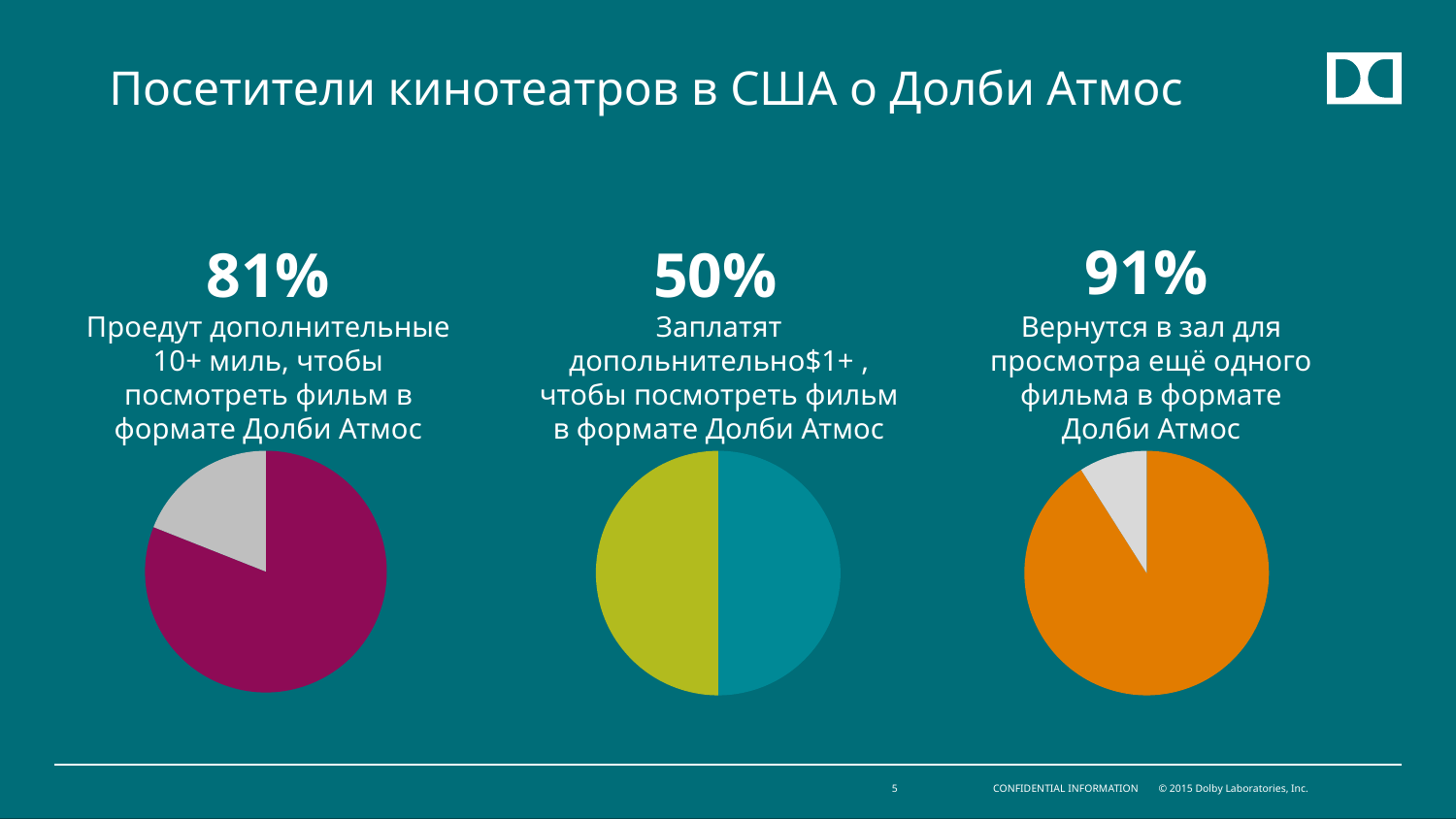
What percentage of US moviegoers would pay an extra $1+ to see a film in Dolby Atmos (middle chart)? 50% What colour is the large slice in the right pie chart? Orange Which of the three statistics on the slide is the lowest? 50% (would pay an extra $1+) How many pie charts are on the slide? 3 What percentage of US moviegoers would drive an extra 10+ miles to see a film in Dolby Atmos (left chart)? 81% What percentage of US moviegoers would return to see another film in Dolby Atmos (right chart)? 91% Which of the three statistics on the slide is the highest? 91% (would return to see another film in Dolby Atmos) What is the difference in percentage points between the share who would return for another Dolby Atmos film and the share who would drive 10+ extra miles? 10 percentage points In the left pie chart, what share does the grey slice represent? 19% What kind of charts are shown on the slide? Pie charts Is the share of moviegoers who would drive 10+ extra miles larger or smaller than the share who would pay $1+ extra? Larger How many slices does each pie chart on the slide have? 2